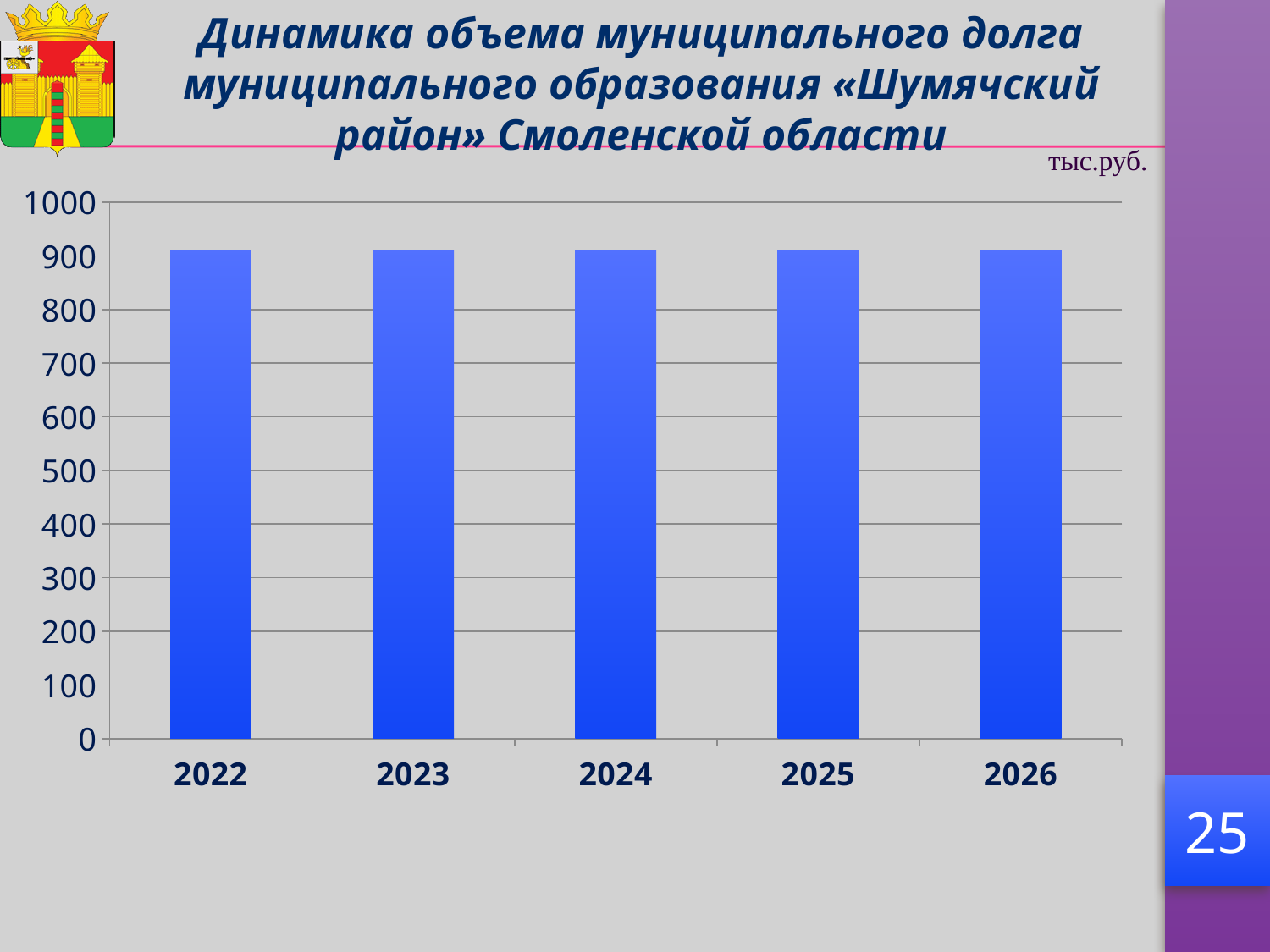
What unit of measurement is indicated above the chart? тыс.руб. Is the value for 2026 greater or less than 500? greater What is the first year shown on the x axis? 2022 Is the value for 2023 greater or less than 700? greater How many years are shown on the x axis of the chart? 5 What kind of chart is shown on the slide? bar chart Do the values rise, fall or stay flat from 2022 to 2026? stay flat Is the value for 2025 greater or less than 1000? less